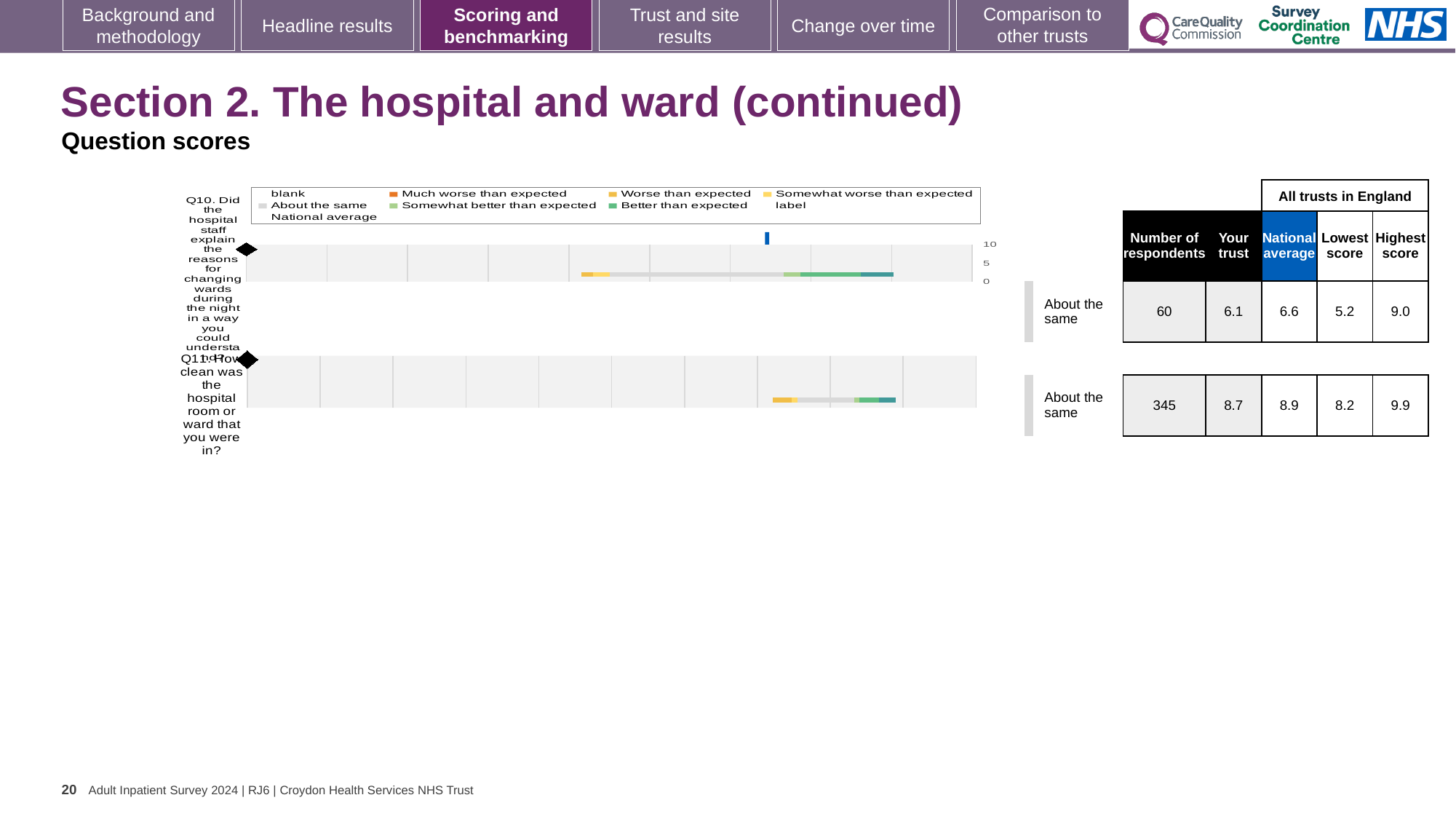
Which legend entry is shown in orange? Much worse than expected What is the lowest score among all trusts in England for Q10? 5.2 What is the 'Your trust' score for Q10 (explaining reasons for changing wards during the night)? 6.1 What kind of chart is used to show the question scores for Q10 and Q11? bar chart What benchmark category is shown for Q10? About the same Which is larger for Q11: the trust's score or the national average? National average Which question has the higher 'Your trust' score, Q10 or Q11? Q11 How many questions are plotted on the slide? 2 How many respondents answered Q11? 345 What is the difference between the national average and the trust's score for Q10? 0.5 What is the national average score for Q11 (how clean was the hospital room or ward)? 8.9 What is the highest score among all trusts in England for Q11? 9.9